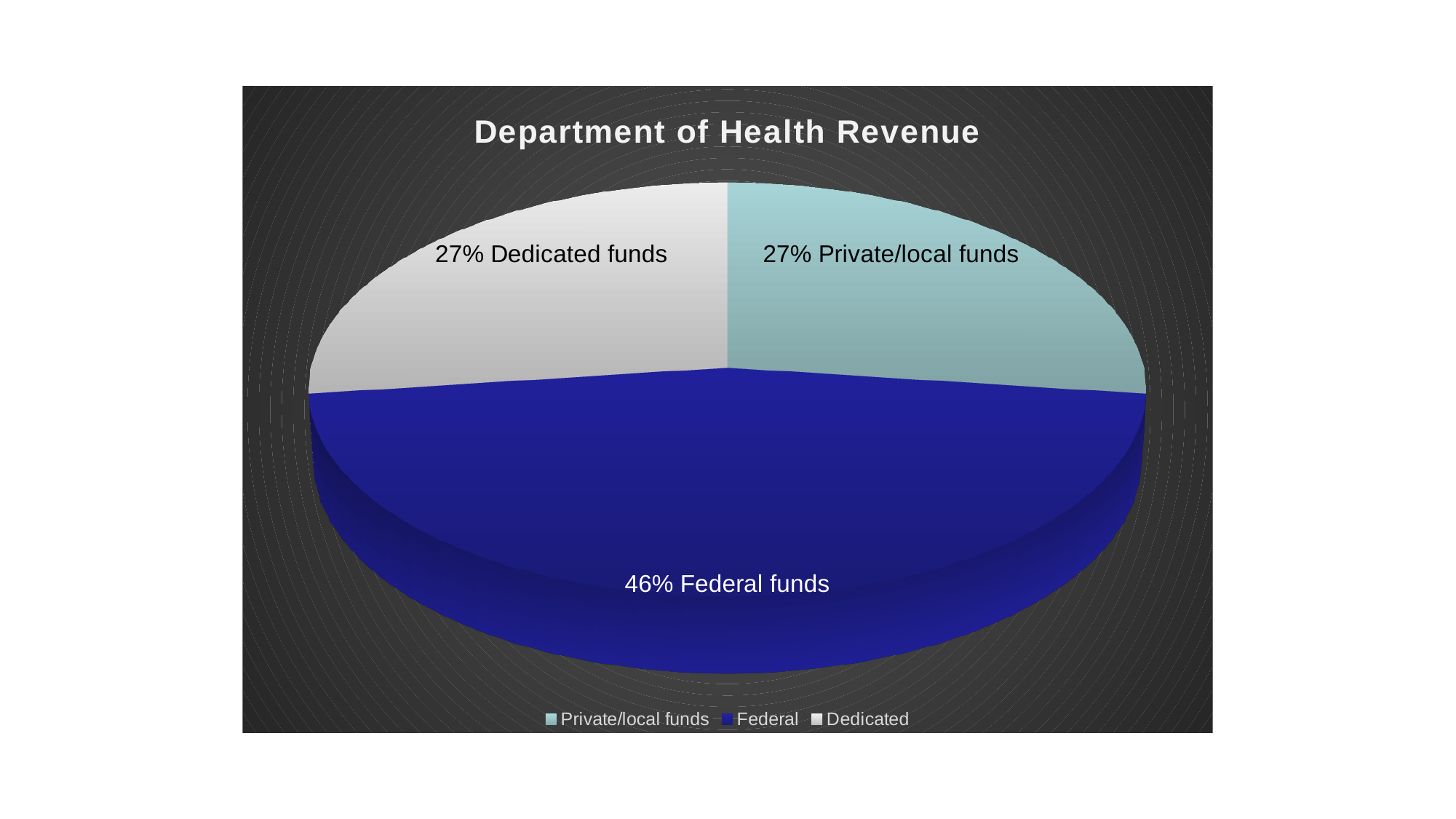
What is the difference in percentage points between the Federal funds slice and the Dedicated funds slice? 19 How many entries does the legend list? 3 What share of Department of Health Revenue comes from Federal funds? 46% Which legend entry is shown in dark blue? Federal What kind of chart is shown on the slide? pie chart What share of Department of Health Revenue comes from Private/local funds? 27% What is the title of the chart? Department of Health Revenue Is the Federal funds share greater or less than 50%? less How many slices does the pie chart have? 3 What share of Department of Health Revenue comes from Dedicated funds? 27% Which is larger, the Federal funds slice or the Private/local funds slice? Federal funds Which revenue source has the largest slice of the pie? Federal funds